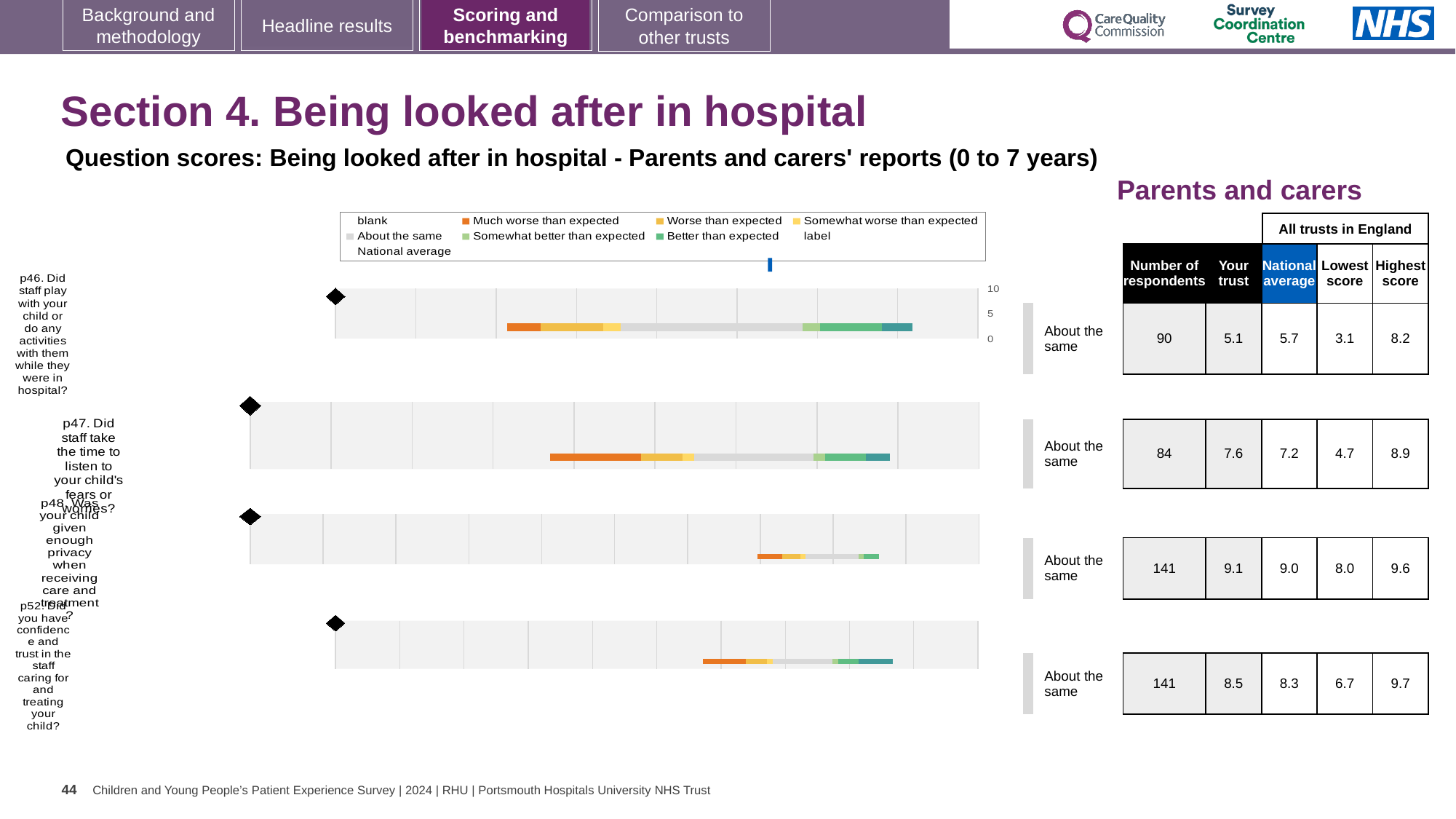
What colour in the legend represents 'Much worse than expected'? orange How many respondents answered p46 (Did staff play with your child or do any activities with them while they were in hospital)? 90 What is the highest score among all trusts in England for p52 (Did you have confidence and trust in the staff caring for and treating your child)? 9.7 For p47, what is the difference between the 'Your trust' score and the national average? 0.4 How many survey questions (charts) are shown on the slide? 4 What kind of chart is used to show the question scores on this slide? bar chart What benchmark category is shown for p46? About the same For p52, which is larger: the 'Your trust' score or the national average? Your trust What is the 'Your trust' score for p47 (Did staff take the time to listen to your child's fears or worries)? 7.6 Which question has the lowest 'Your trust' score? p46 Which question has the highest 'Your trust' score? p48 What is the national average score for p48 (Was your child given enough privacy when receiving care and treatment)? 9.0